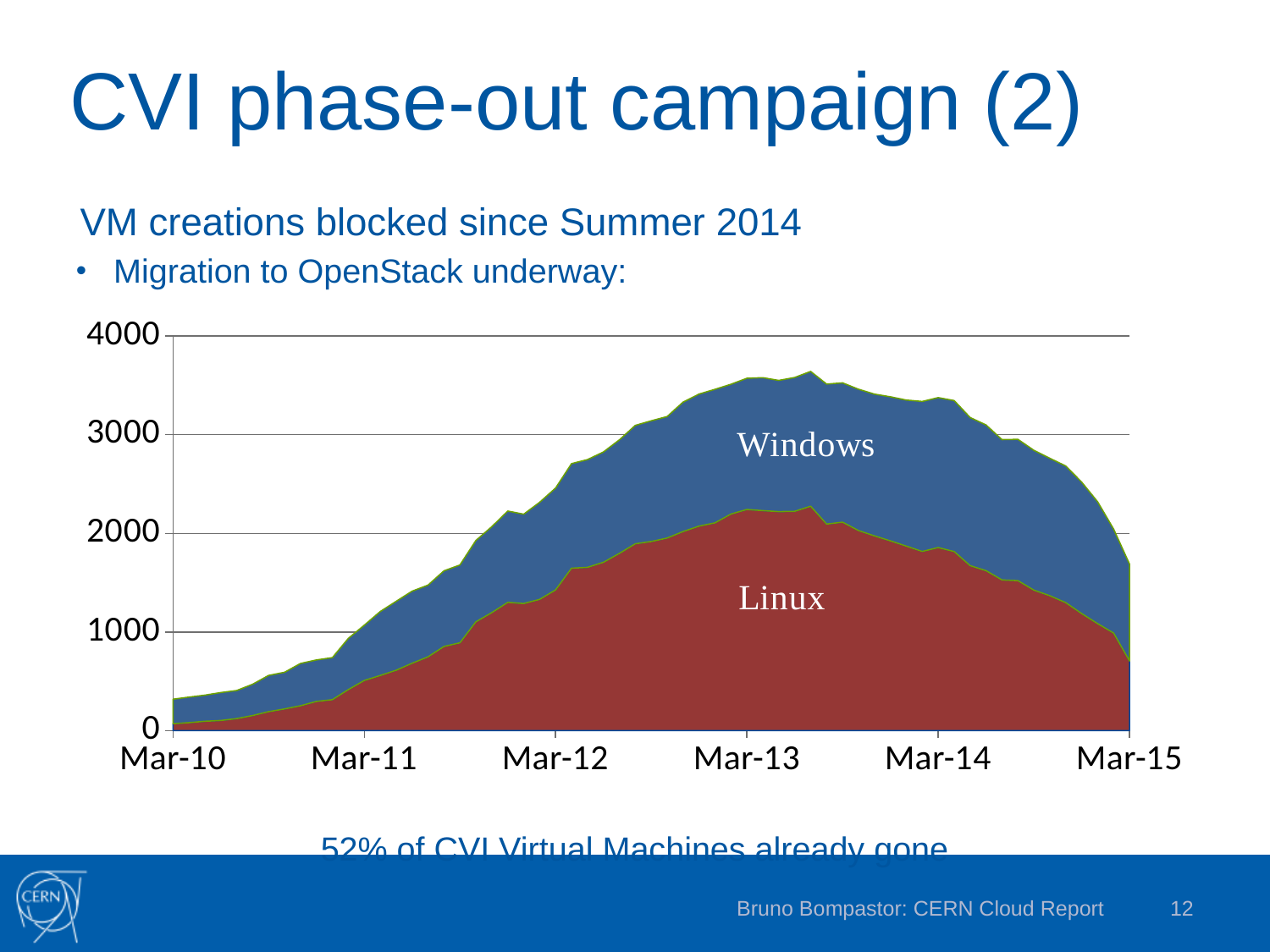
What kind of chart is shown on the slide? Stacked area chart At Mar-13, which series has the larger value, Windows or Linux? Linux Is the total of Windows and Linux at Mar-15 greater or less than 2000? less How many series are plotted in the chart? 2 Is the Linux value at Mar-13 greater or less than 2000? greater How many date labels are shown on the x axis? 6 Is the total of Windows and Linux at Mar-13 greater or less than 3000? greater Which series is stacked on top in the chart? Windows Which two series are labelled in the chart? Windows and Linux Does the total number of VMs rise or fall between Mar-13 and Mar-15? fall